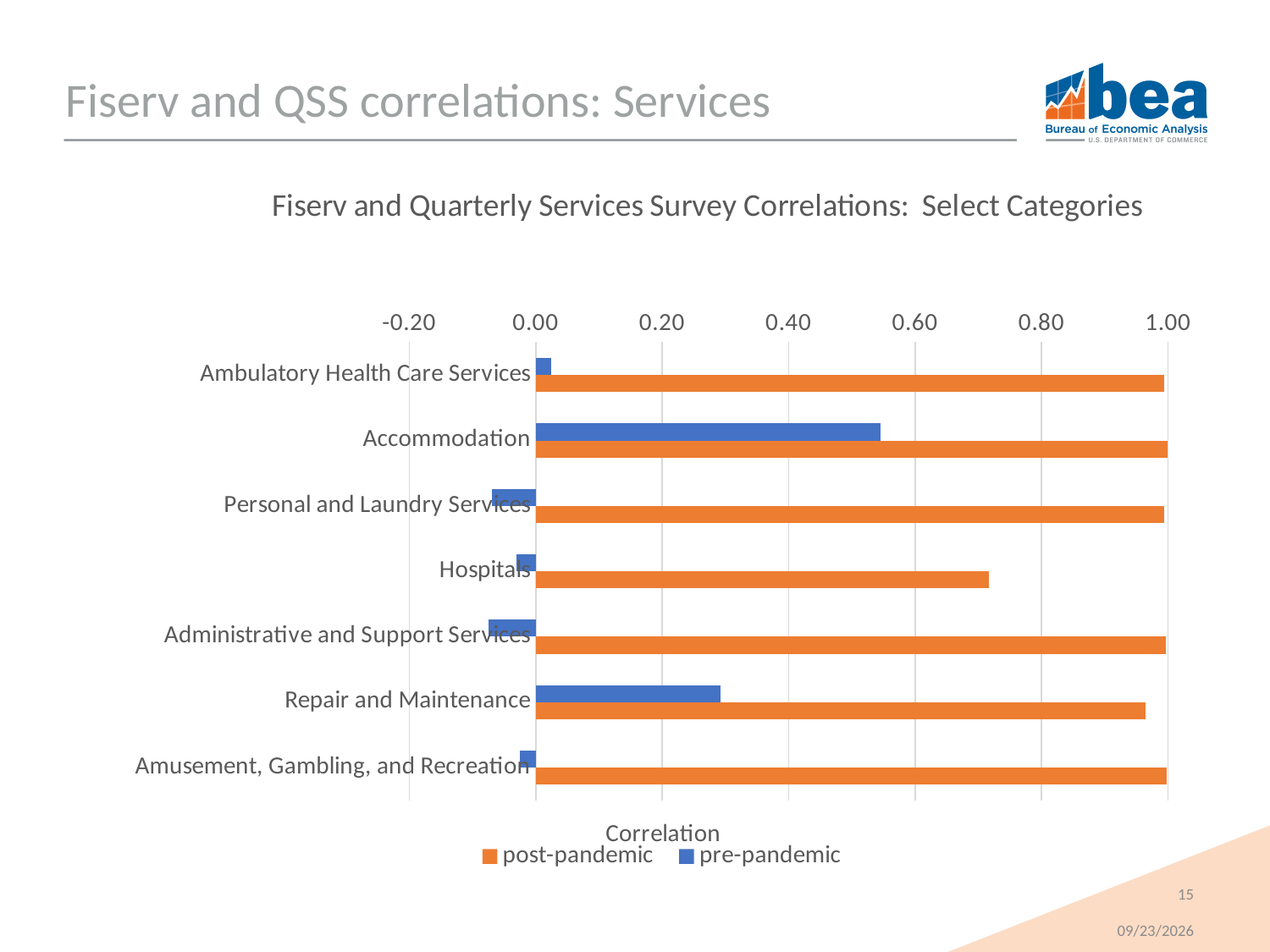
Which category has the highest pre-pandemic correlation? Accommodation What kind of chart is shown on the slide? Bar chart How many series does the legend list? 2 Is the post-pandemic correlation for Hospitals greater or less than 0.80? less What is the title of the chart? Fiserv and Quarterly Services Survey Correlations: Select Categories Which is larger: the pre-pandemic correlation for Accommodation or for Repair and Maintenance? Accommodation Is the pre-pandemic correlation for Repair and Maintenance greater or less than 0.40? less Which colour represents the post-pandemic series? Orange Is the post-pandemic correlation for Hospitals greater or less than 0.60? greater How many categories are plotted on the chart? 7 Which category has the lowest post-pandemic correlation? Hospitals